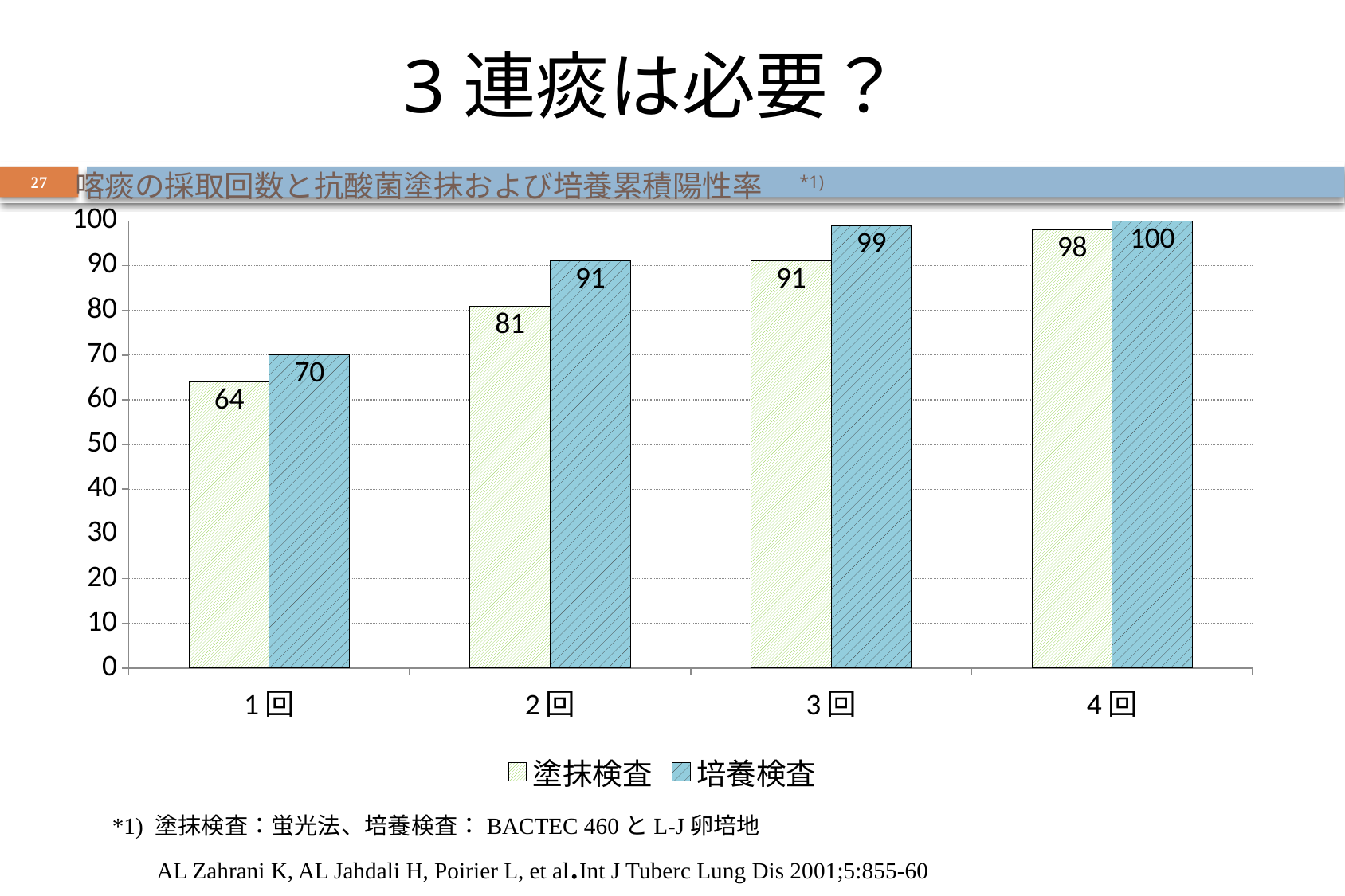
What is the value of 培養検査 for 3回? 99 How many series does the legend list? 2 What are the two series named in the legend? 塗抹検査 and 培養検査 What is the value of 塗抹検査 for 1回? 64 What is the difference between 培養検査 and 塗抹検査 for 2回? 10 What is the value of 培養検査 for 4回? 100 Do the values for 塗抹検査 rise or fall from 1回 to 4回? rise What kind of chart is shown on the slide? bar chart Which category has the lowest value for 塗抹検査? 1回 Which is larger for 1回: 塗抹検査 or 培養検査? 培養検査 Which category has the highest value for 培養検査? 4回 How many categories are shown on the x axis? 4